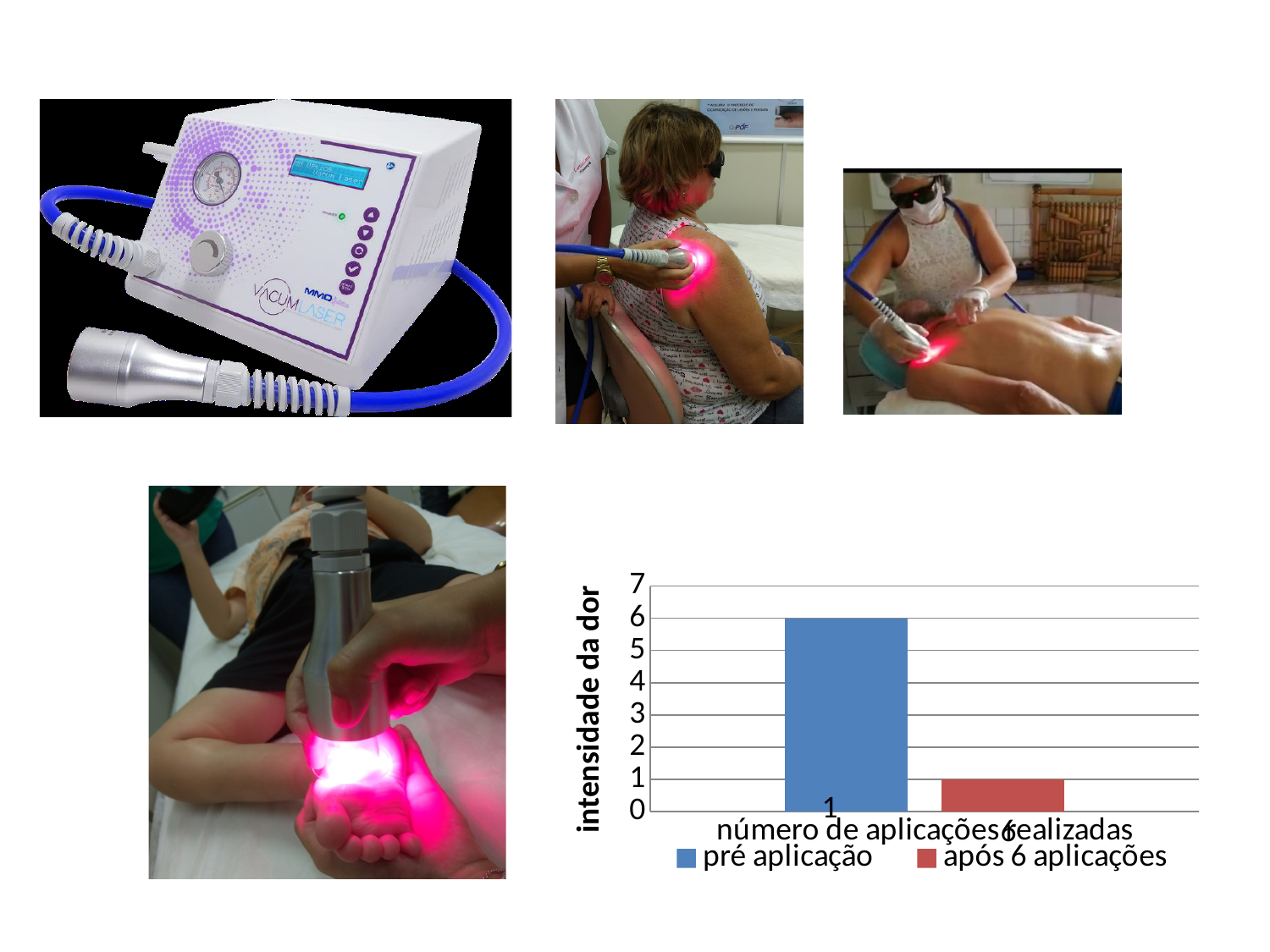
How many series does the chart legend list? 2 Is the value for 'pré aplicação' greater or less than 4? greater Which series has the higher value, 'pré aplicação' or 'após 6 aplicações'? pré aplicação Which series has the lowest value in the chart? após 6 aplicações What is the value of the 'após 6 aplicações' bar? 1 Is the value for 'após 6 aplicações' greater or less than 3? less What is the title of the vertical axis of the chart? intensidade da dor What is the difference between the 'pré aplicação' value and the 'após 6 aplicações' value? 5 Which series has the highest value in the chart? pré aplicação What type of chart is shown on the slide? bar chart What colour is the 'após 6 aplicações' bar in the chart? red What is the value of the 'pré aplicação' bar? 6